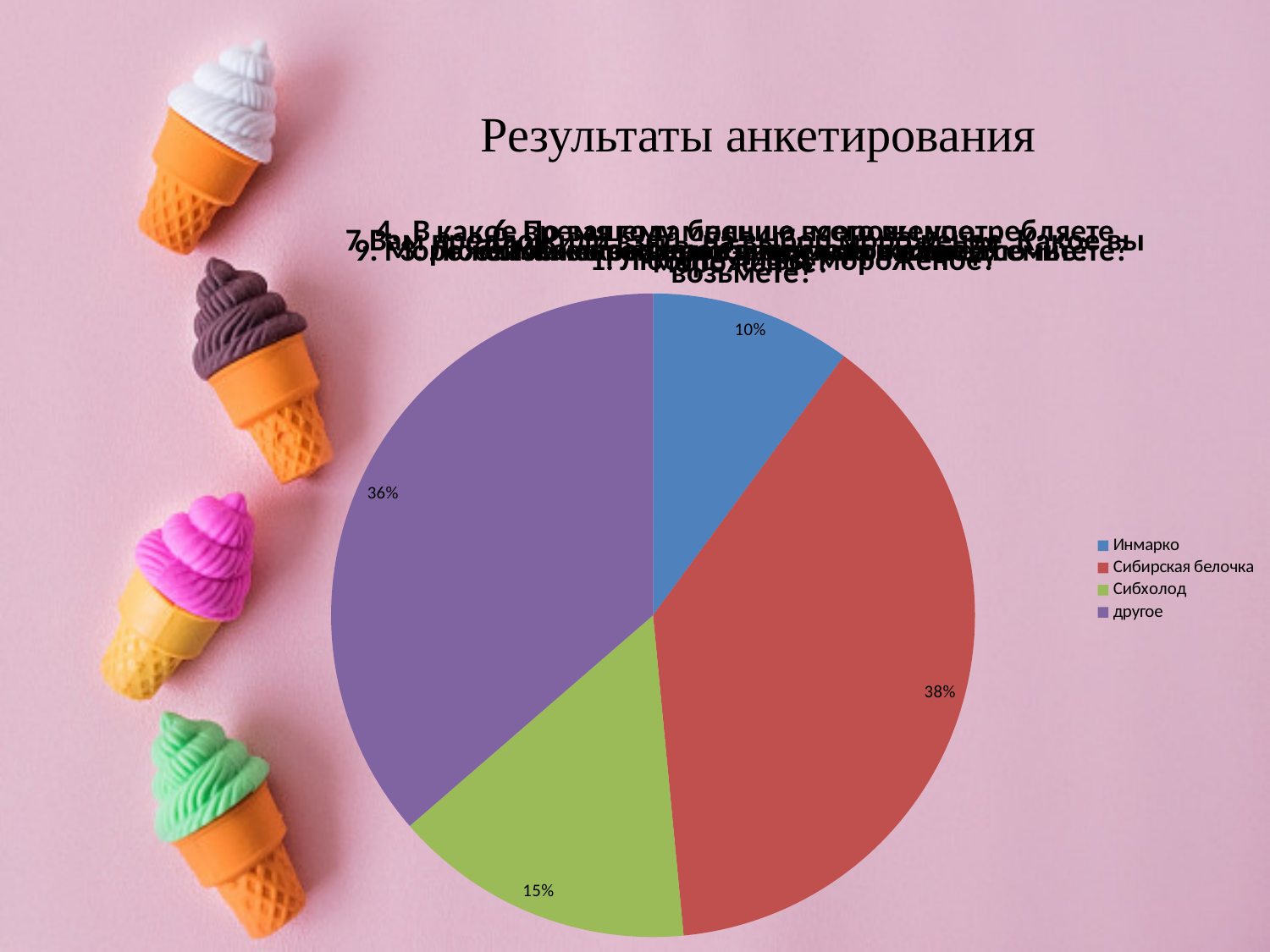
What kind of chart is shown on the slide? pie chart What percentage of the pie does Сибхолод account for? 15% Which category has the largest share of the pie? Сибирская белочка What is the difference in percentage points between Сибирская белочка and Сибхолод? 23 What colour is the slice for другое in the pie chart? purple Which is larger, the share for Сибхолод or the share for Инмарко? Сибхолод What percentage of the pie does Сибирская белочка account for? 38% What percentage of the pie does the category другое account for? 36% How many slices does the pie chart have? 4 What percentage of the pie does Инмарко account for? 10% Which category has the smallest share of the pie? Инмарко What is the combined share of Инмарко and Сибхолод? 25%